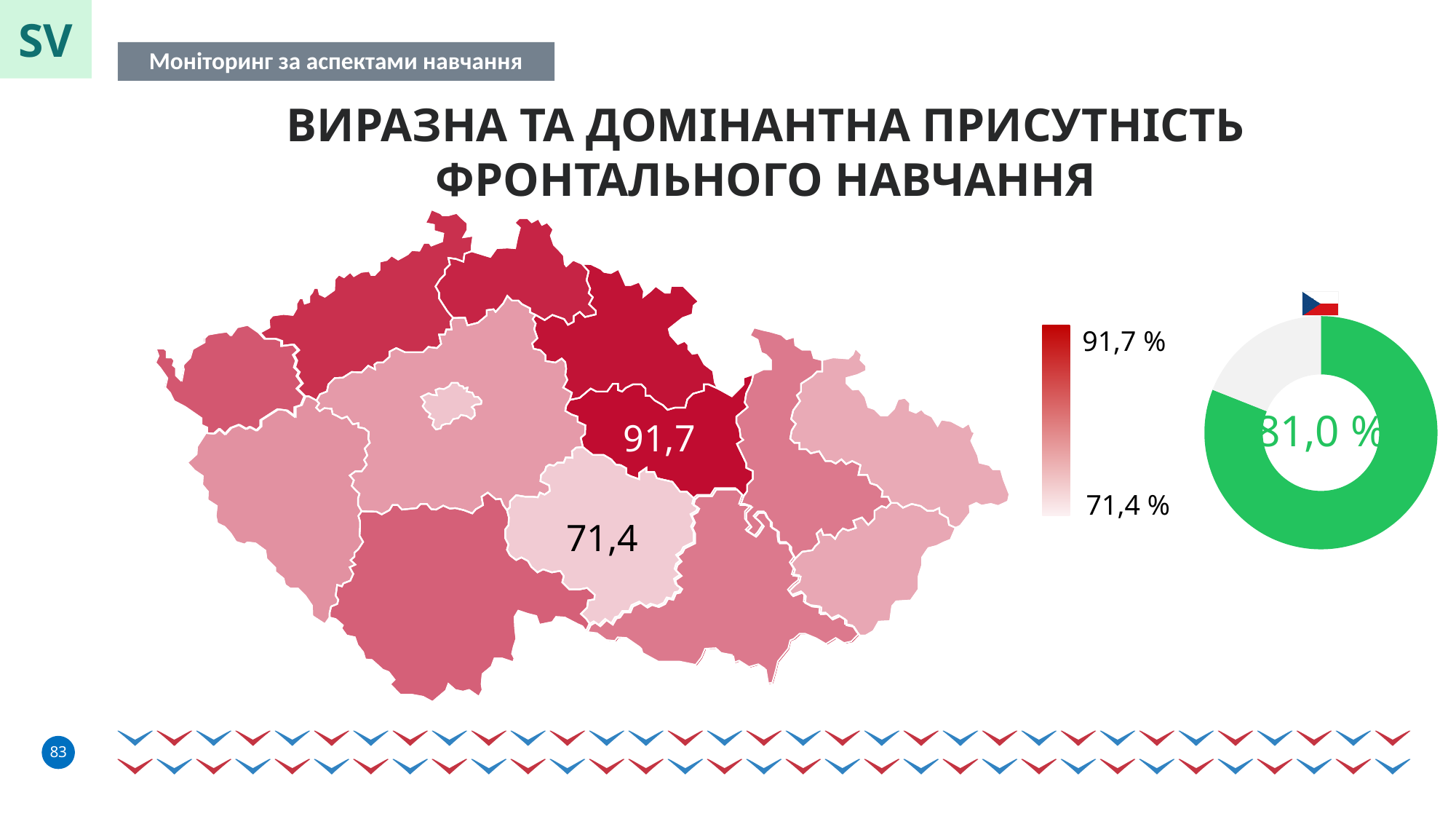
On the map of the Czech Republic, what is the highest value printed on a region? 91,7 On the map of the Czech Republic, what is the lowest value printed on a region? 71,4 What kind of chart is shown on the right side of the slide? Donut (pie) chart What colour is the filled portion of the donut chart? Green On the donut chart on the right, what percentage is printed in the centre? 81,0 % What kind of chart is shown on the left side of the slide? Choropleth map On the map's colour scale, what value is shown at the top (darkest red) end? 91,7 % On the donut chart, is the value shown greater or less than 50%? greater On the map's colour scale, what value is shown at the bottom (lightest) end? 71,4 % Which country's flag is shown above the donut chart? Czech Republic On the map of the Czech Republic, what is the difference between the highest printed value (91,7) and the lowest printed value (71,4)? 20,3 Which is larger: the highest value printed on the map (91,7) or the value on the donut chart (81,0 %)? 91,7